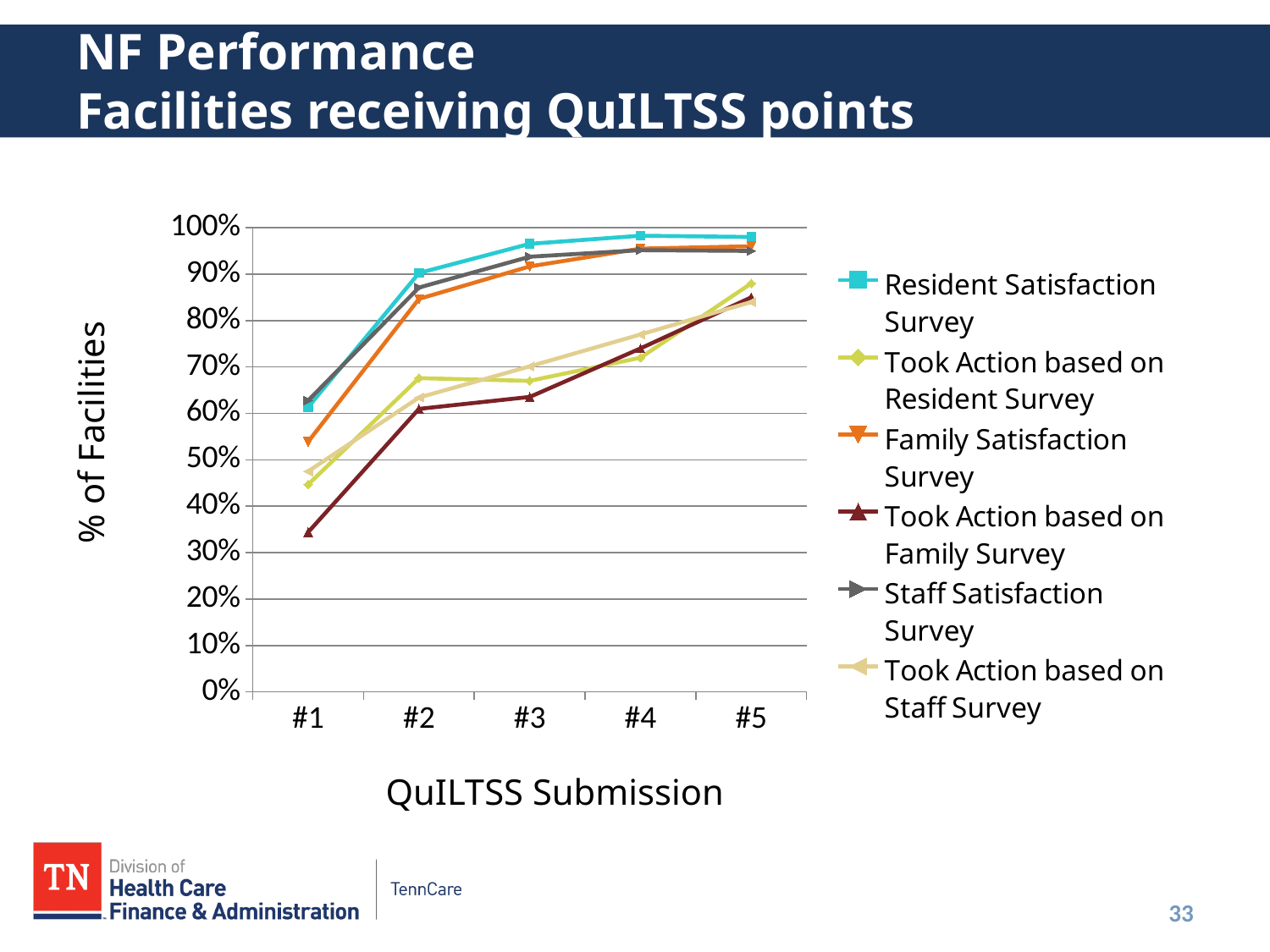
Is the value for Resident Satisfaction Survey at submission #2 greater or less than 80%? greater At submission #3, which is larger: Resident Satisfaction Survey or Took Action based on Resident Survey? Resident Satisfaction Survey What is the title of the y axis? % of Facilities At submission #1, which is larger: Family Satisfaction Survey or Took Action based on Family Survey? Family Satisfaction Survey How many QuILTSS submissions are shown on the x axis? 5 Is the value for Took Action based on Family Survey at submission #1 greater or less than 40%? less How many series does the legend list? 6 Is the value for Staff Satisfaction Survey at submission #1 greater or less than 70%? less Which series has the lowest value at submission #1? Took Action based on Family Survey What kind of chart is shown on the slide? Line chart Do the values for Resident Satisfaction Survey rise or fall from submission #1 to submission #5? Rise